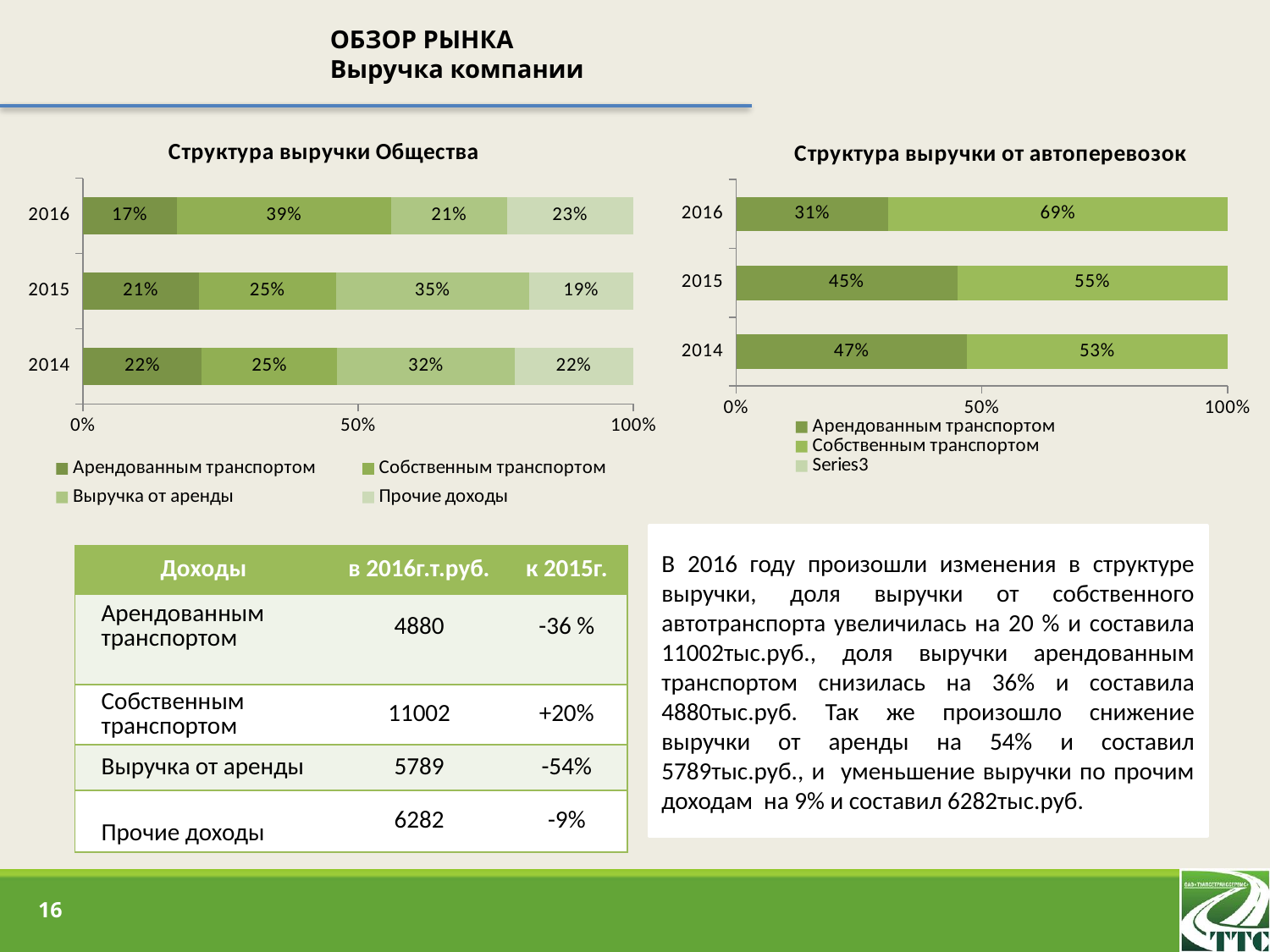
In the chart 'Структура выручки Общества', what is the share of 'Собственным транспортом' in 2016? 39% In the chart 'Структура выручки Общества', what is the difference between the 'Собственным транспортом' share in 2016 and in 2015? 14% What kind of chart is 'Структура выручки от автоперевозок'? stacked bar chart In the chart 'Структура выручки Общества', how many years are shown? 3 In the chart 'Структура выручки от автоперевозок', what is the share of 'Арендованным транспортом' in 2014? 47% In the chart 'Структура выручки от автоперевозок', what is the share of 'Собственным транспортом' in 2016? 69% In the chart 'Структура выручки Общества', which year has the highest share for 'Собственным транспортом'? 2016 In the chart 'Структура выручки Общества', how many series does the legend list? 4 In the chart 'Структура выручки от автоперевозок', does the share of 'Арендованным транспортом' rise or fall from 2014 to 2016? fall In the chart 'Структура выручки Общества', what is the share of 'Прочие доходы' in 2014? 22% In the chart 'Структура выручки Общества', what is the share of 'Выручка от аренды' in 2015? 35% In the chart 'Структура выручки от автоперевозок', which year has the lowest share for 'Арендованным транспортом'? 2016